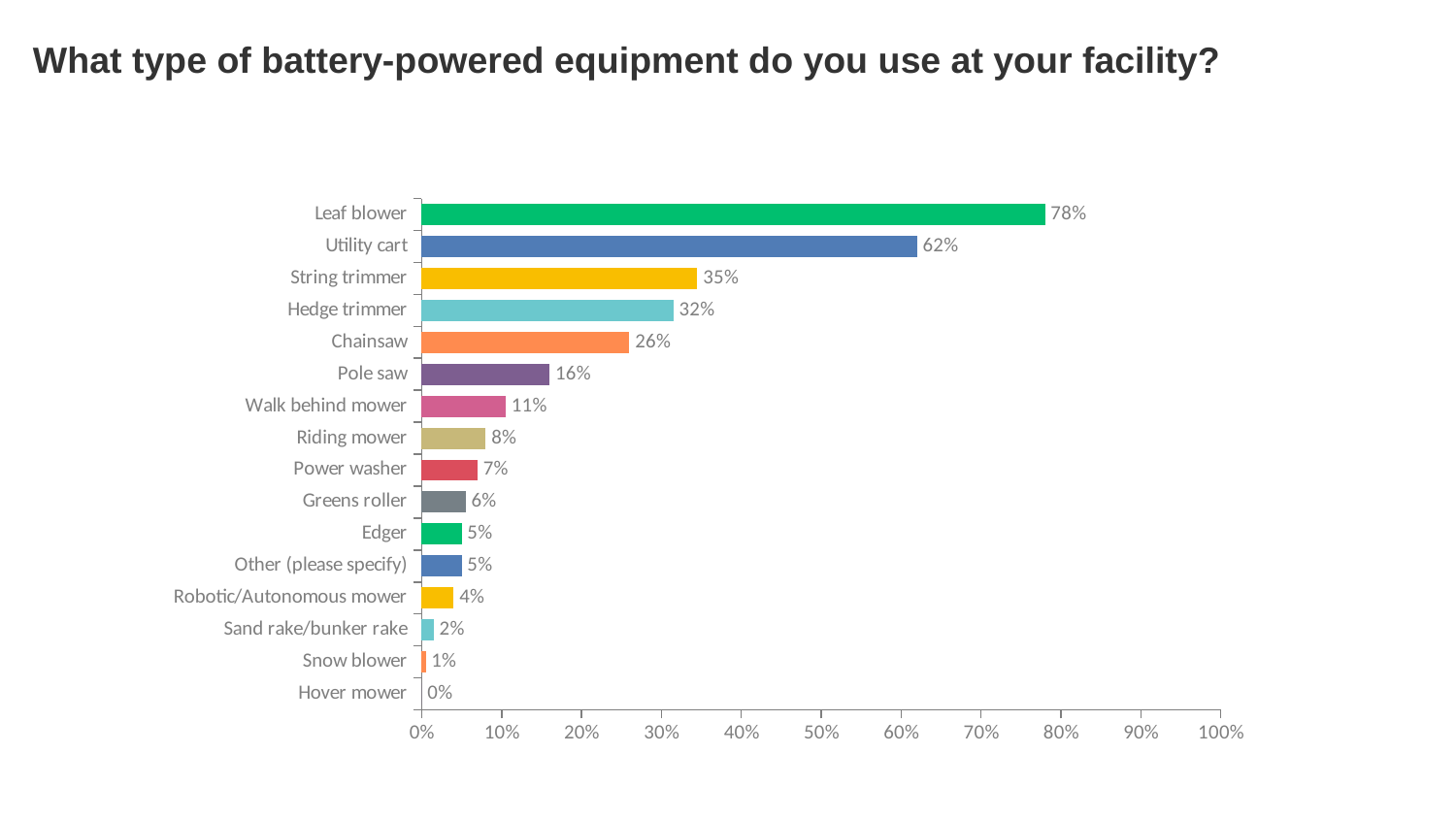
What kind of chart is shown on the slide? Bar chart Is the value for Pole saw greater or less than 20%? less Which type of equipment has the highest percentage? Leaf blower What is the title of the chart? What type of battery-powered equipment do you use at your facility? Which type of equipment has the lowest percentage? Hover mower Which has a higher value, String trimmer or Hedge trimmer? String trimmer What percentage is shown for Chainsaw? 26% What is the value for Robotic/Autonomous mower? 4% What is the value shown for Utility cart? 62% How many equipment categories are shown in the chart? 16 What is the difference in percentage points between Leaf blower and Utility cart? 16 What percentage of respondents use a battery-powered leaf blower? 78%